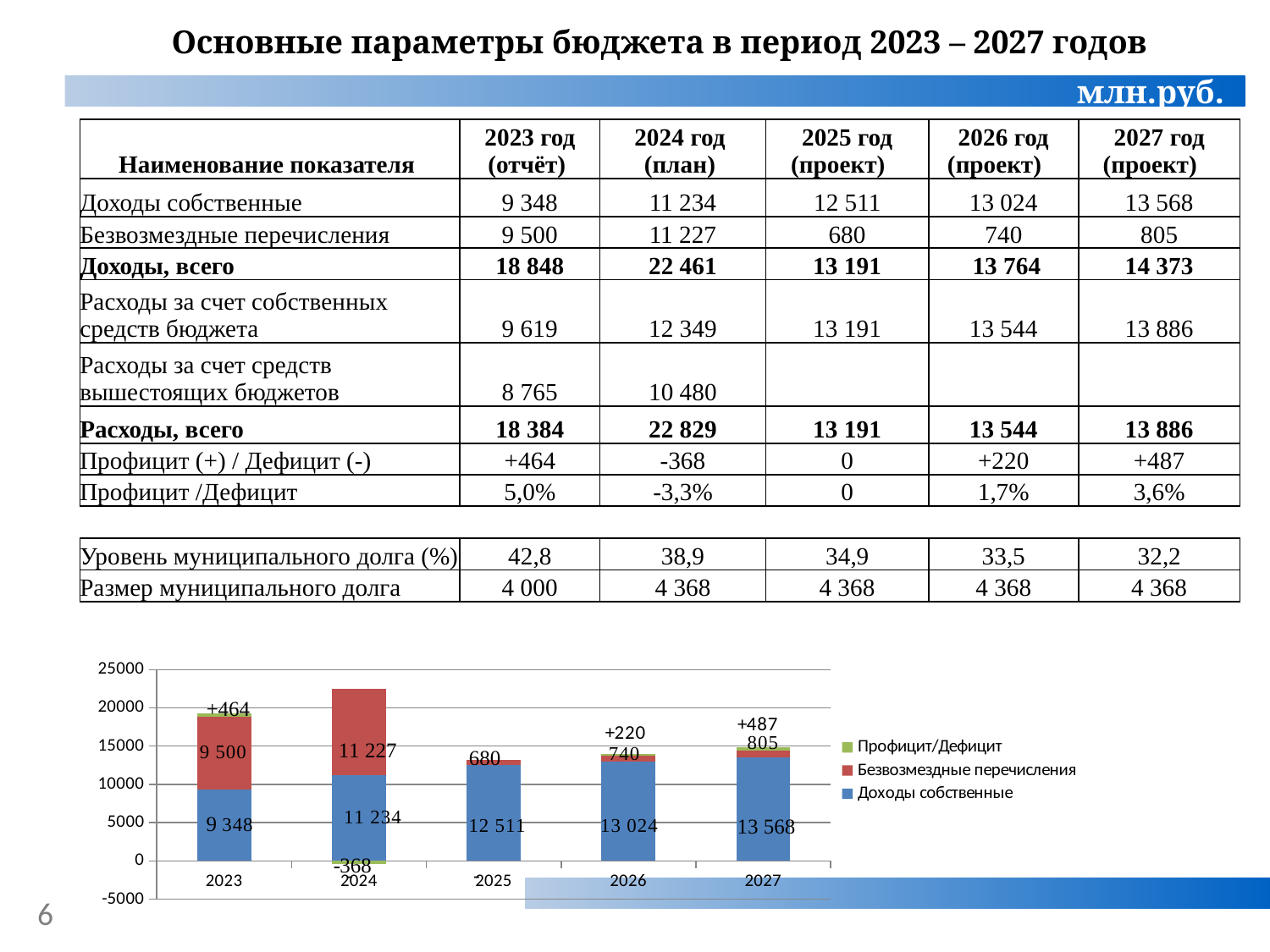
In the chart, which year has the lowest value for Безвозмездные перечисления? 2025 In the chart, is Безвозмездные перечисления larger in 2023 or in 2026? 2023 In the chart, which series is shown in red? Безвозмездные перечисления In the chart, which year has the highest value for Доходы собственные? 2027 In the chart, does the value of Доходы собственные rise or fall from 2023 to 2027? rise How many years are shown on the x axis of the chart? 5 In the chart, what is the Профицит/Дефицит value labelled for 2027? +487 How many series does the chart legend list? 3 In the chart, what is the value of Безвозмездные перечисления for 2024? 11 227 What kind of chart is shown at the bottom of the slide? stacked bar chart In the chart, what is the value of Доходы собственные for 2025? 12 511 In the chart, what is the difference between Доходы собственные in 2027 and in 2026? 544